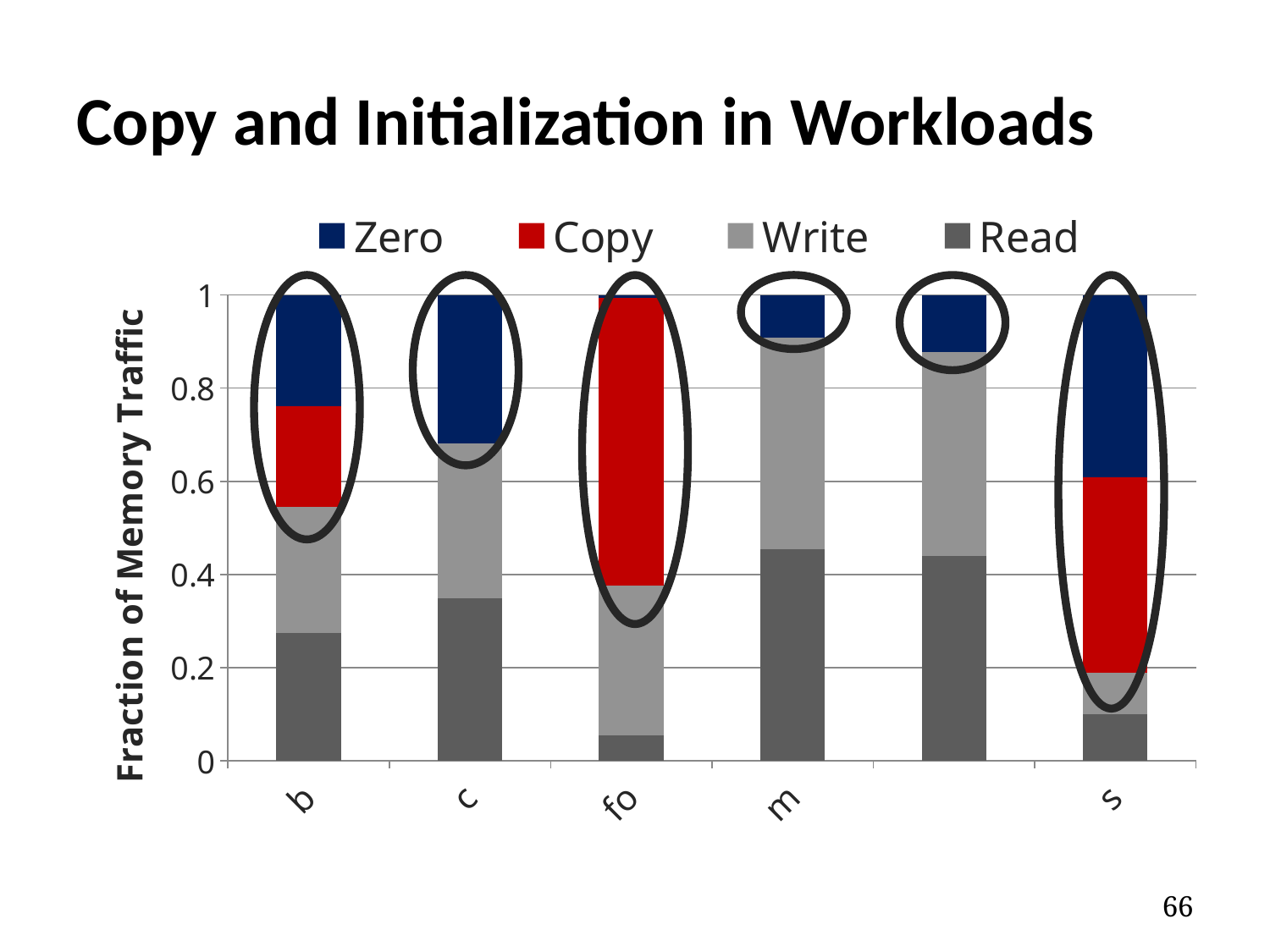
What is the total height of the stacked bar for b? 1 Is the Read segment for fo greater or less than 0.2? less Is the Copy segment larger for fo or for b? fo Which workload has the largest Copy segment? fo How many series does the legend list? 4 What is the title of the chart on the slide? Copy and Initialization in Workloads How many stacked bars are plotted in the chart? 6 Is the top of the Copy segment for fo greater or less than 0.8? greater Is the Read segment for b greater or less than 0.4? less What is the label of the vertical axis? Fraction of Memory Traffic What kind of chart is shown on the slide? stacked bar chart Is the Zero segment larger for c or for m? c